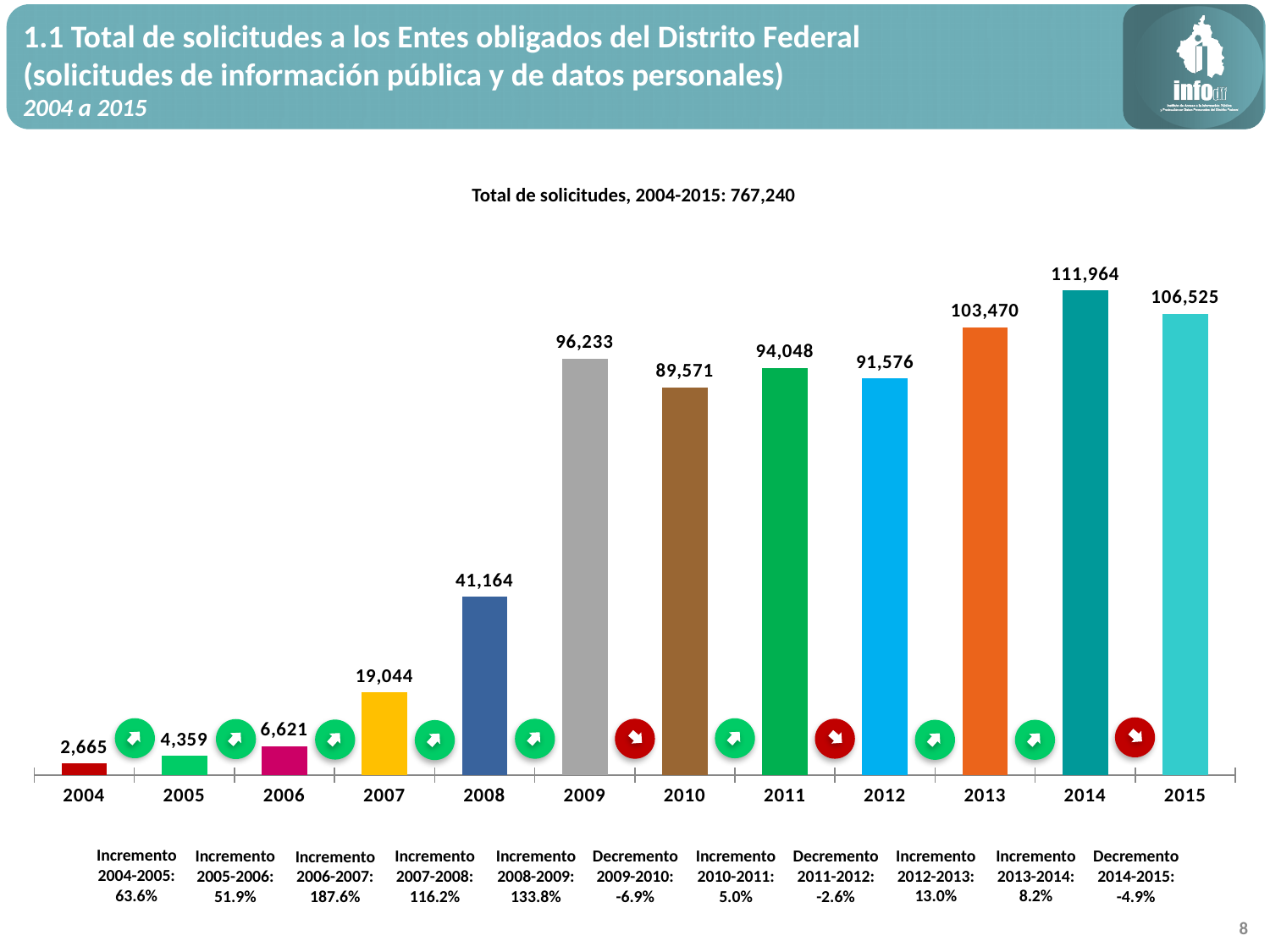
What kind of chart is shown on the slide? Bar chart What is the value for 2013? 103,470 How many years are shown on the x axis? 12 Which year has the highest value? 2014 What is the value for 2004? 2,665 What total of solicitudes for 2004-2015 is stated above the chart? 767,240 Which is larger, the value for 2009 or the value for 2010? 2009 Which year has the lowest value? 2004 What is the difference between the values for 2014 and 2015? 5,439 What is the value for 2008? 41,164 What percentage change is stated for 2006-2007? 187.6% Do the values generally rise or fall from 2004 to 2014? Rise